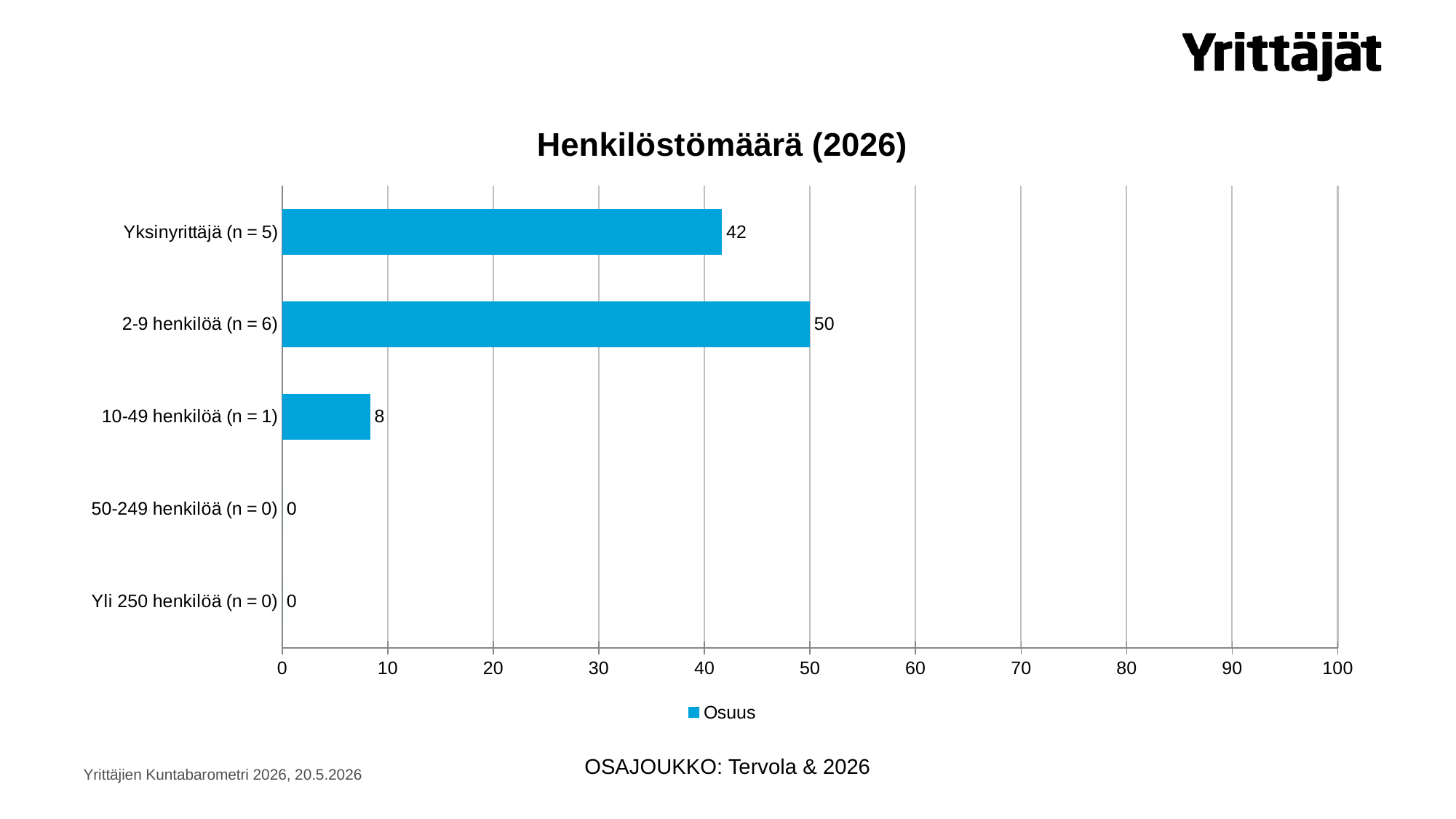
What is the value for 2-9 henkilöä (n = 6)? 50 What is the difference between the values for 2-9 henkilöä (n = 6) and Yksinyrittäjä (n = 5)? 8 What is the value for Yksinyrittäjä (n = 5)? 42 What is the title of the chart? Henkilöstömäärä (2026) Which is larger, the value for Yksinyrittäjä (n = 5) or the value for 10-49 henkilöä (n = 1)? Yksinyrittäjä (n = 5) How many series does the legend list? 1 What is the value for 10-49 henkilöä (n = 1)? 8 How many categories are shown on the chart? 5 Which category has the highest value? 2-9 henkilöä (n = 6) Is the value for Yksinyrittäjä (n = 5) greater or less than 30? greater What kind of chart is shown on the slide? bar chart What is the value for 50-249 henkilöä (n = 0)? 0